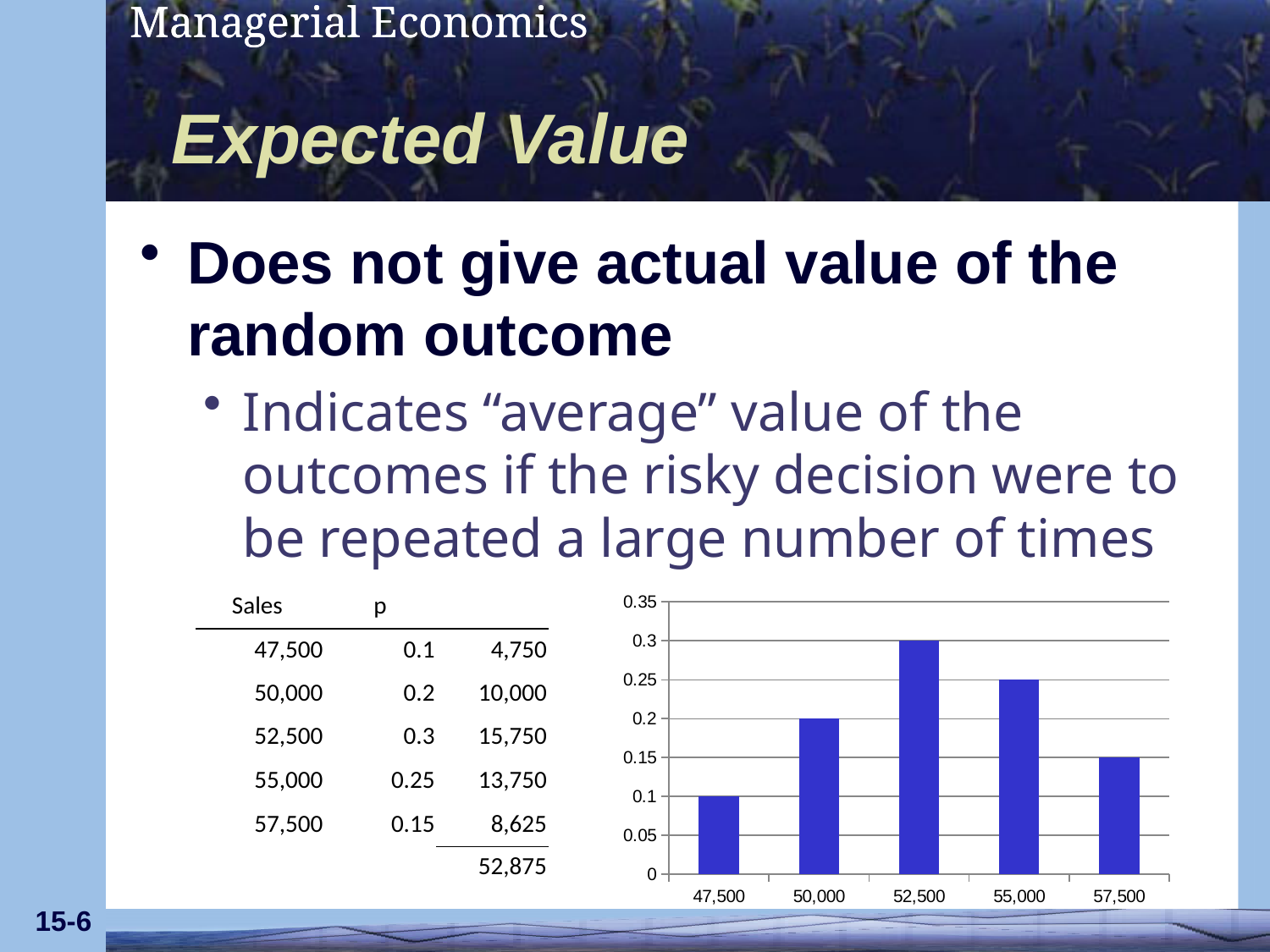
What is the highest value shown on the vertical axis? 0.35 Is the value for 50,000 greater or less than 0.15? greater What is the value of the bar for 55,000? 0.25 What kind of chart is shown on the slide? bar chart How many bars are plotted in the chart? 5 What is the value of the bar for 52,500? 0.3 What is the difference between the values for 52,500 and 47,500? 0.2 Which category has the highest bar? 52,500 What is the value of the bar for 57,500? 0.15 Which bar is taller, 50,000 or 55,000? 55,000 What is the value of the bar for 47,500? 0.1 Which category has the lowest bar? 47,500